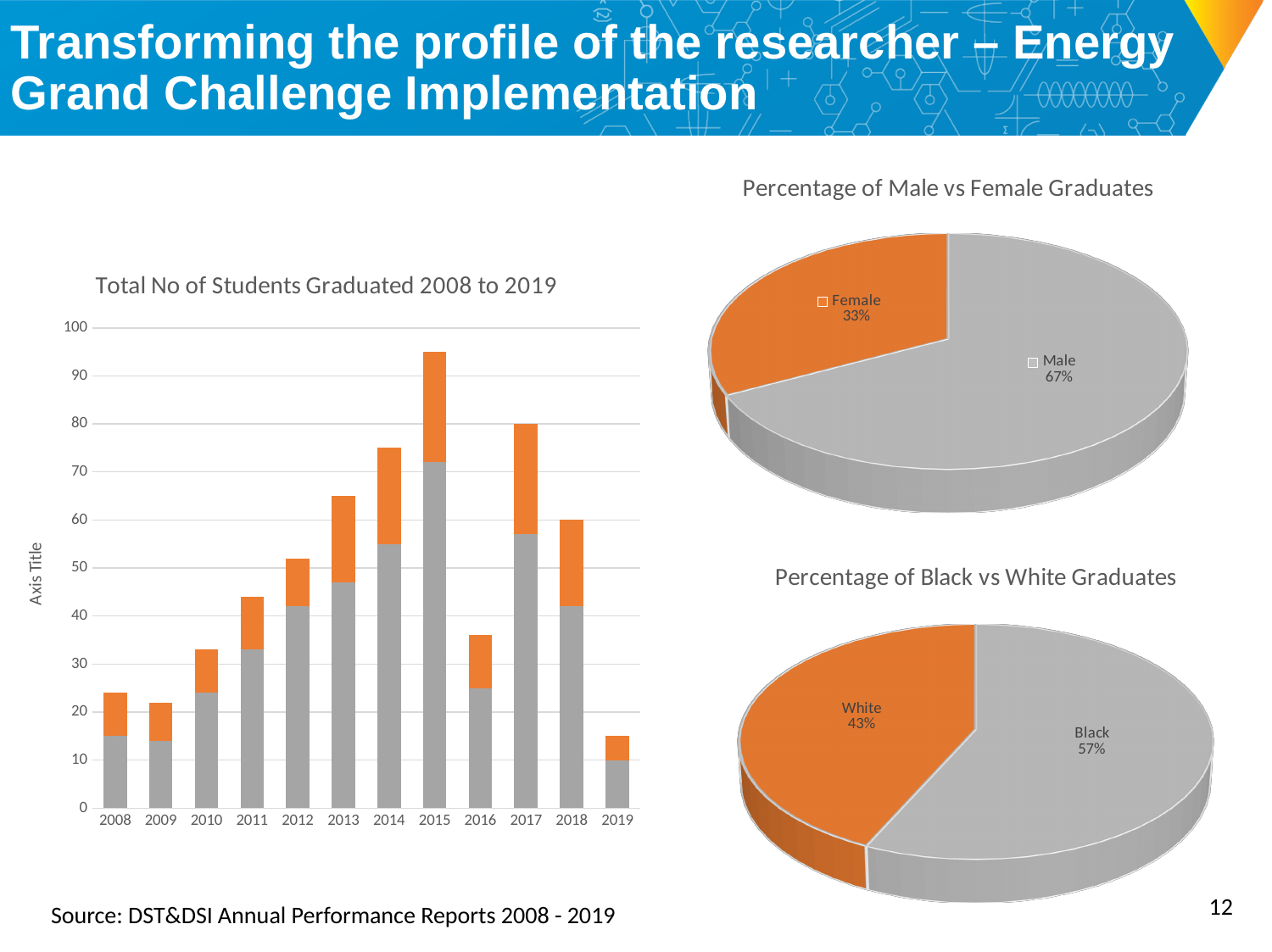
In the "Total No of Students Graduated 2008 to 2019" chart, is the total for 2015 greater or less than 90? greater In the "Percentage of Black vs White Graduates" pie chart, what share is White? 43% In the "Percentage of Male vs Female Graduates" pie chart, what share is Male? 67% In the "Percentage of Black vs White Graduates" pie chart, what is the difference in percentage points between Black and White? 14 What kind of chart is "Total No of Students Graduated 2008 to 2019"? Bar chart In the "Total No of Students Graduated 2008 to 2019" chart, which year has the larger total, 2017 or 2018? 2017 In the "Total No of Students Graduated 2008 to 2019" chart, is the total for 2016 greater or less than 40? less In the "Total No of Students Graduated 2008 to 2019" chart, is the total for 2013 greater or less than 60? greater In the "Total No of Students Graduated 2008 to 2019" chart, which year has the tallest bar? 2015 In the "Total No of Students Graduated 2008 to 2019" chart, which year has the shortest bar? 2019 In the "Percentage of Male vs Female Graduates" pie chart, what share is Female? 33% In the "Total No of Students Graduated 2008 to 2019" chart, how many years are shown on the x axis? 12